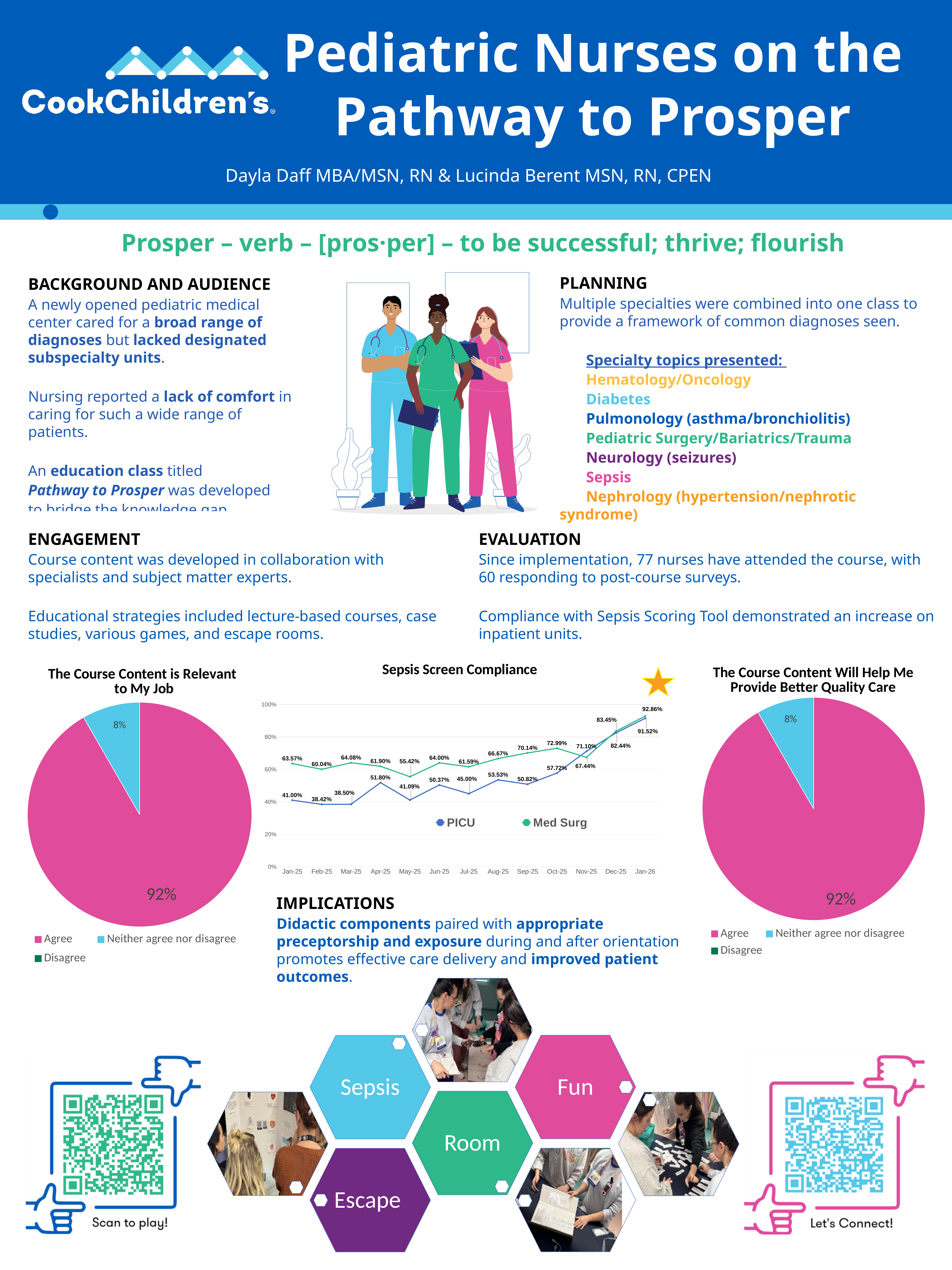
In the pie chart titled 'The Course Content is Relevant to My Job', what share of responses is Agree? 92% In the Sepsis Screen Compliance chart, how many series does the legend list? 2 In the Sepsis Screen Compliance chart, what is the PICU value for Jan-26? 91.52% In the Sepsis Screen Compliance chart, how many months are plotted on the x axis? 13 In the Sepsis Screen Compliance chart, which series has the higher value in May-25, PICU or Med Surg? Med Surg In the Sepsis Screen Compliance chart, does the PICU series rise or fall from Oct-25 to Jan-26? Rise In the Sepsis Screen Compliance chart, what is the difference between the Med Surg and PICU values in Dec-25? 1.01% What kind of chart is the Sepsis Screen Compliance chart? Line chart In the Sepsis Screen Compliance chart, which month has the highest Med Surg value? Jan-26 In the pie chart titled 'The Course Content Will Help Me Provide Better Quality Care', what share of responses is Neither agree nor disagree? 8% In the Sepsis Screen Compliance chart, which month has the lowest PICU value? Feb-25 In the Sepsis Screen Compliance chart, what is the Med Surg value for Jan-25? 63.57%